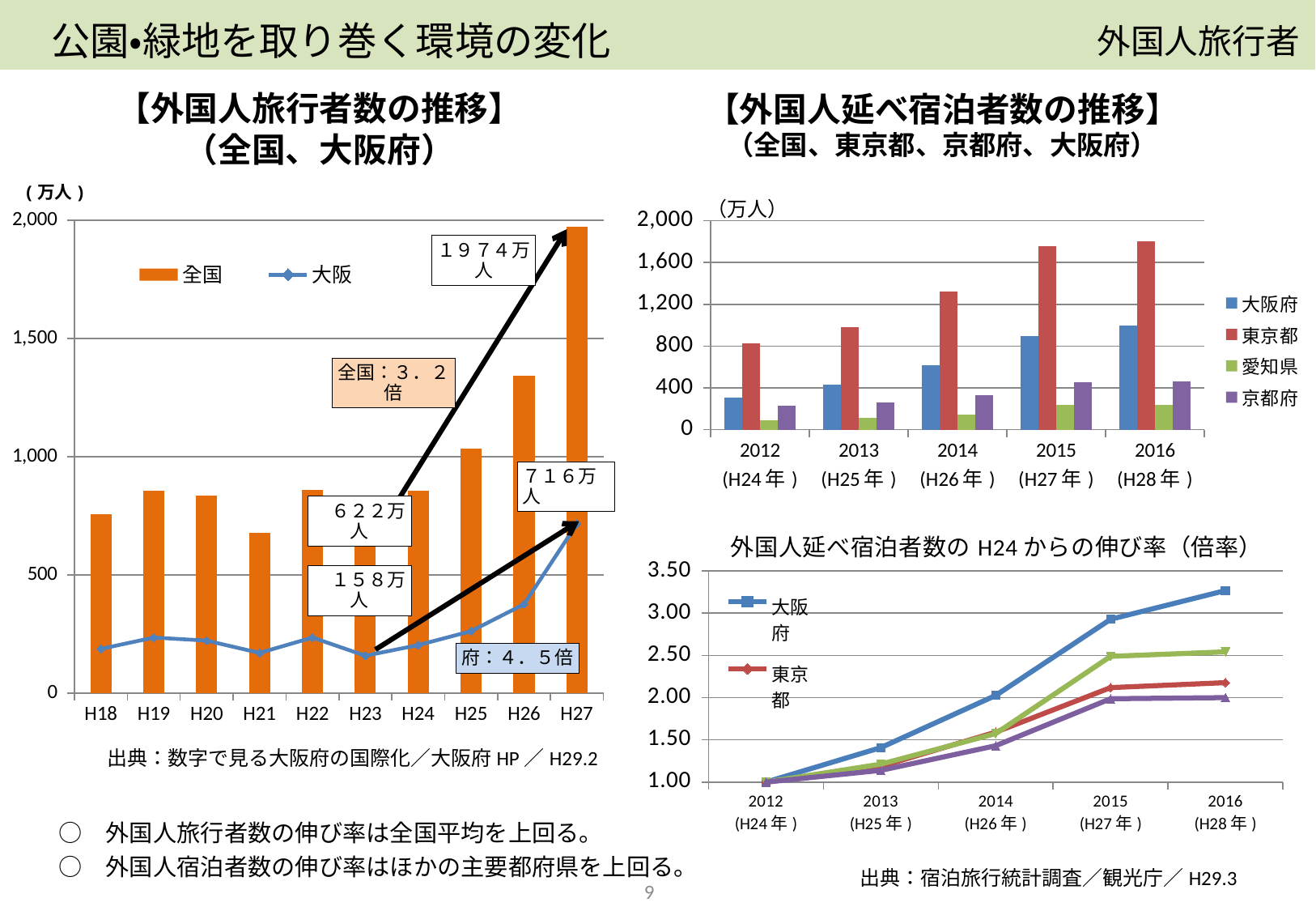
In the left chart 【外国人旅行者数の推移】, how many years are shown on the x axis? 10 In the left chart 【外国人旅行者数の推移】, what is the labelled value for 大阪 in H27? 716万人 In the top-right chart 【外国人延べ宿泊者数の推移】, is the 東京都 value for 2015 greater or less than 1,600? greater In the left chart 【外国人旅行者数の推移】, what growth multiple is shown for 全国? 3.2倍 In the left chart 【外国人旅行者数の推移】, what is the labelled value for 大阪 in H23? 158万人 In the left chart 【外国人旅行者数の推移】, is the 全国 value for H26 greater or less than 1,000? greater In the top-right chart 【外国人延べ宿泊者数の推移】, how many series does the legend list? 4 In the left chart 【外国人旅行者数の推移】, what growth multiple is shown for 府 (大阪府)? 4.5倍 What type of chart is the bottom-right chart 外国人延べ宿泊者数の H24 からの伸び率? line chart In the left chart 【外国人旅行者数の推移】, which year has the highest 全国 bar? H27 In the top-right chart 【外国人延べ宿泊者数の推移】, which prefecture has the tallest bar in 2016? 東京都 In the left chart 【外国人旅行者数の推移】, what is the labelled value for 全国 in H27? 1974万人